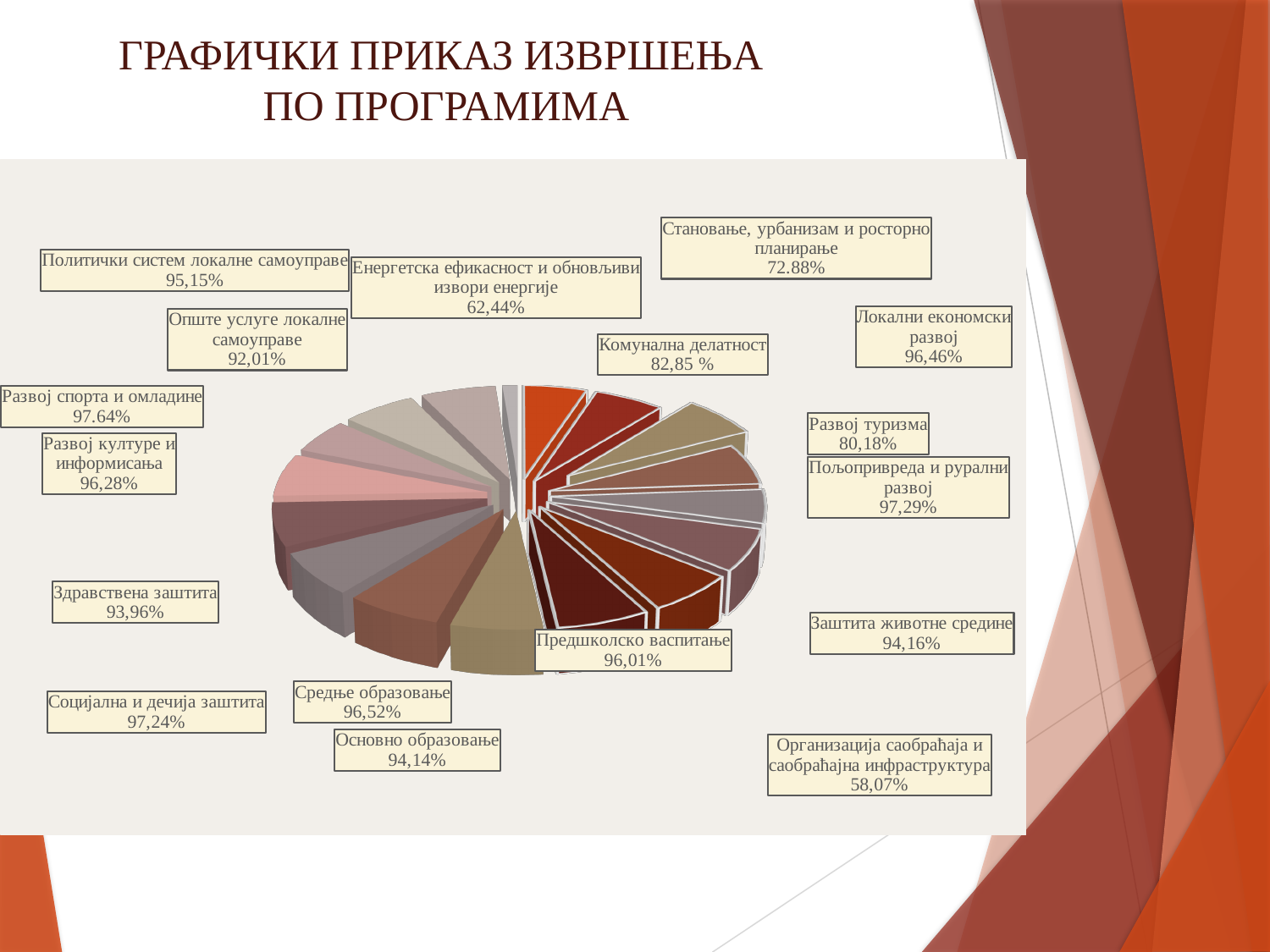
What is the value shown for Становање, урбанизам и росторно планирање? 72.88% Which program has the highest value shown on the chart? Развој спорта и омладине Which has the larger value, Комунална делатност or Развој туризма? Комунална делатност What is the value shown for Енергетска ефикасност и обновљиви извори енергије? 62,44% How many programs are labelled on the chart? 17 What kind of chart is shown on the slide? pie chart Which program has the lowest value shown on the chart? Организација саобраћаја и саобраћајна инфраструктура What is the value shown for Предшколско васпитање? 96,01% What is the difference between the values for Пољопривреда и рурални развој and Развој туризма? 17,11 What is the value shown for Организација саобраћаја и саобраћајна инфраструктура? 58,07% What is the title of the slide containing the chart? ГРАФИЧКИ ПРИКАЗ ИЗВРШЕЊА ПО ПРОГРАМИМА What is the value shown for Комунална делатност? 82,85 %